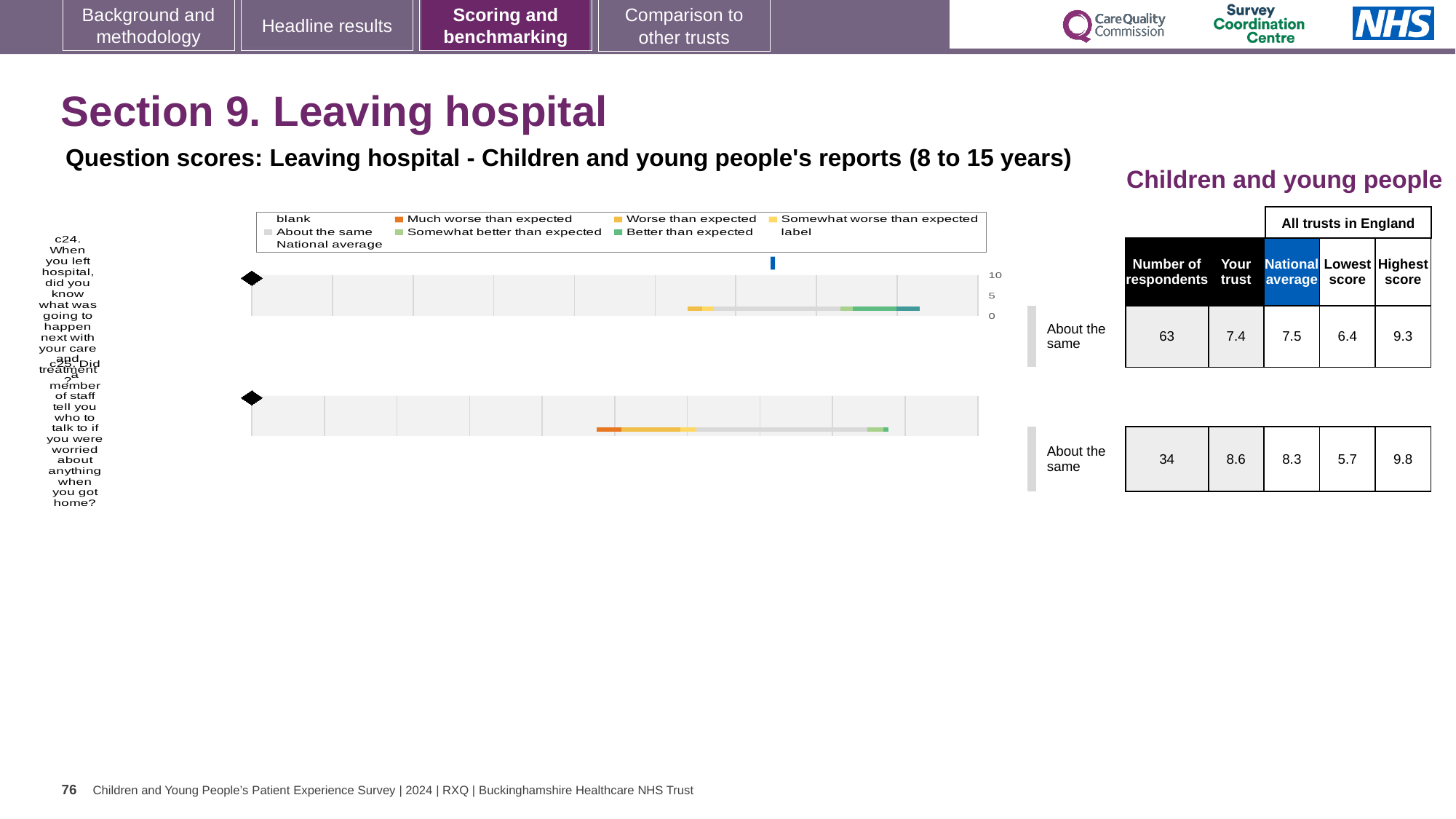
What kind of chart is used to show the question scores on this slide? Bar chart What benchmark category is shown for question c24? About the same For question c24 (When you left hospital, did you know what was going to happen next with your care and treatment?), what is the number of respondents? 63 Which question has the higher 'Your trust' score, c24 or c25? c25 For question c25, what is the highest score among all trusts in England? 9.8 What is the difference between the highest score (9.3) and the lowest score (6.4) for question c24? 2.9 By how much does the trust's score for c25 (8.6) exceed the national average (8.3)? 0.3 For question c24, what is the national average score? 7.5 How many survey questions are plotted on this slide? 2 For question c24, what is the 'Your trust' score? 7.4 For question c25, what is the lowest score among all trusts in England? 5.7 For question c25 (Did a member of staff tell you who to talk to if you were worried about anything when you got home?), what is the 'Your trust' score? 8.6